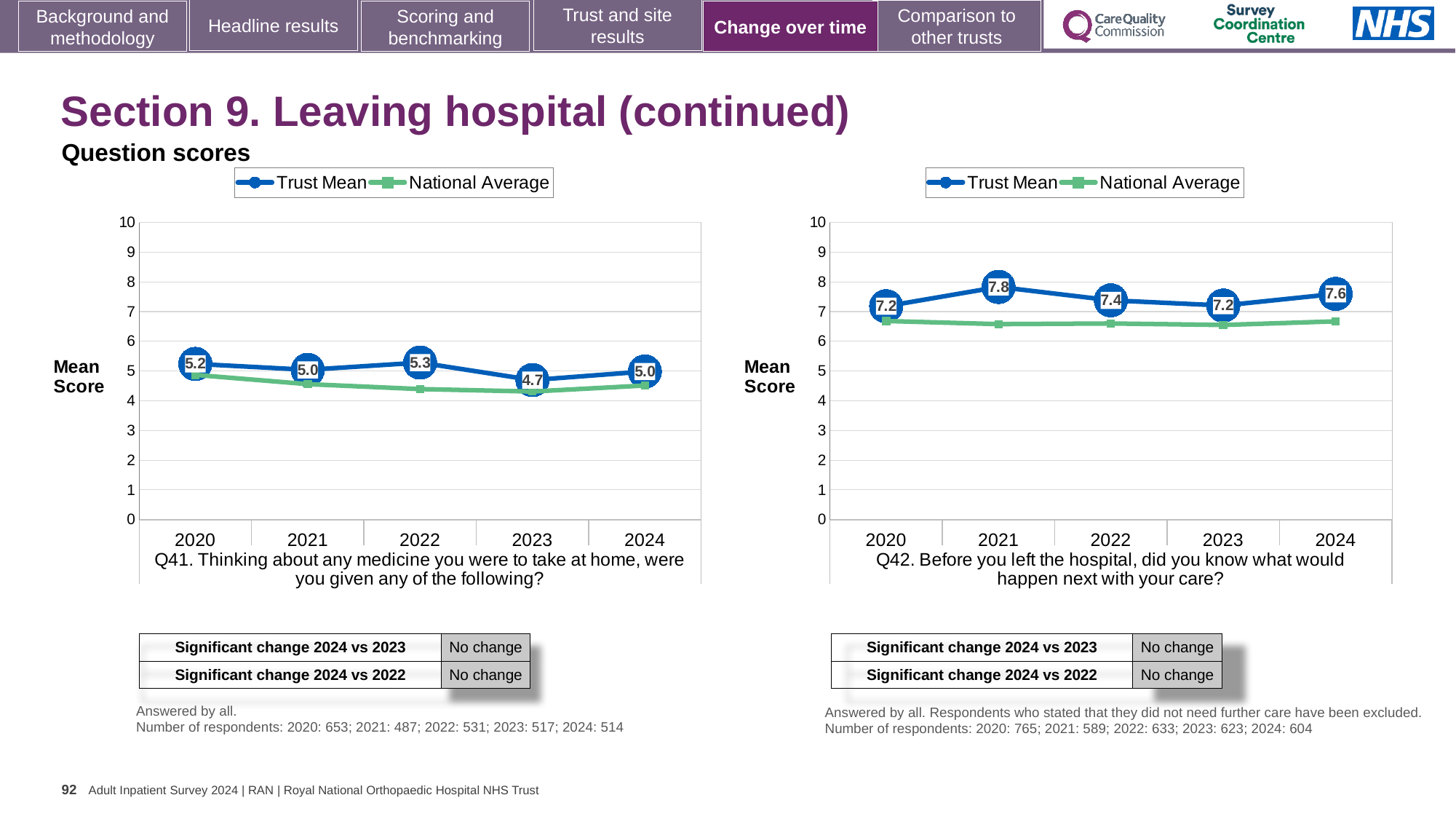
In the Q41 chart (left), what is the Trust Mean score for 2022? 5.3 In the Q42 chart (right), is the Trust Mean score for 2024 higher or lower than for 2023? higher In the Q42 chart (right), which year has the highest Trust Mean score? 2021 In the Q42 chart (right), is the National Average value for 2020 greater or less than 6? greater In the Q42 chart (right), what is the Trust Mean score for 2021? 7.8 In the Q41 chart (left), what is the difference between the Trust Mean scores for 2022 and 2023? 0.6 In the Q42 chart (right), what is the difference between the Trust Mean scores for 2021 and 2023? 0.6 What type of chart is used for Q41 (left)? line chart In the Q41 chart (left), which year has the lowest Trust Mean score? 2023 How many years are shown on the x axis of the Q41 chart (left)? 5 In the Q41 chart (left), is the National Average value for 2023 greater or less than 5? less How many series does the legend of the Q42 chart (right) list? 2